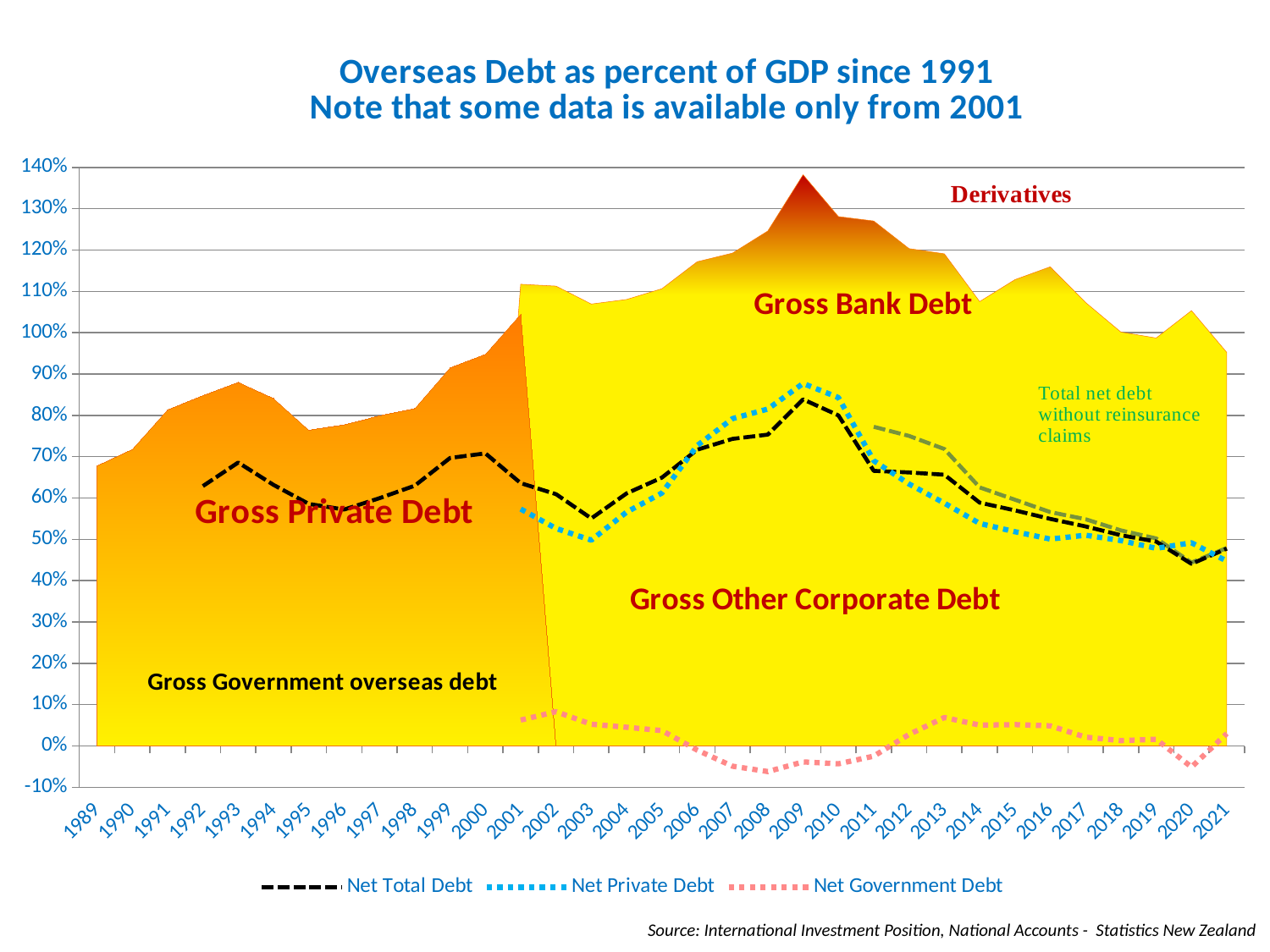
Does Net Total Debt rise or fall between 2009 and 2020? fall In which year does Net Private Debt reach its highest value? 2009 Is the value for Net Private Debt in 2009 greater or less than 80%? greater Which is larger in 2003, Net Total Debt or Net Private Debt? Net Total Debt Is the total gross overseas debt in 2009 greater or less than 130%? greater What kind of chart is shown on the slide? combination area and line chart Is the value for Net Government Debt in 2008 greater or less than 0%? less In which year does the total gross overseas debt (top of the shaded area) reach its highest point? 2009 What is the highest value shown on the y axis? 140% How many series does the legend list? 3 How many years are shown on the x axis? 33